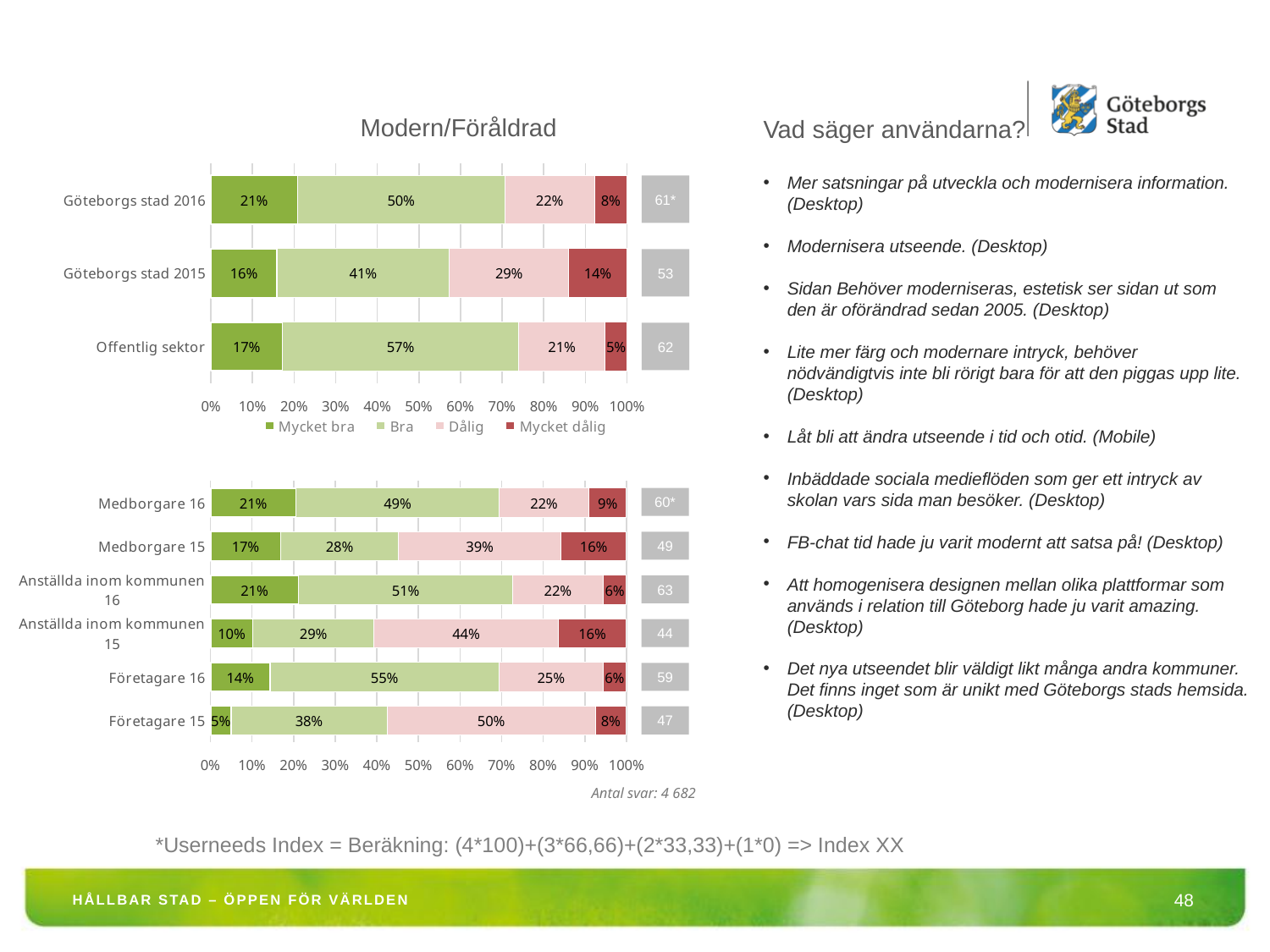
In the top chart titled Modern/Föråldrad, what is the Mycket dålig value for Göteborgs stad 2015? 14% In the top chart titled Modern/Föråldrad, which category has the lowest Mycket dålig value? Offentlig sektor In the top chart titled Modern/Föråldrad, what is the Bra value for Offentlig sektor? 57% In the bottom chart, which category has the highest Bra value? Företagare 16 In the bottom chart, which category has the lowest Mycket bra value? Företagare 15 In the bottom chart, what is the Dålig value for Företagare 15? 50% In the top chart titled Modern/Föråldrad, how many categories are shown? 3 In the top chart titled Modern/Föråldrad, which category has the highest Mycket bra value? Göteborgs stad 2016 What kind of chart is the bottom chart? Stacked bar chart In the bottom chart, is the Dålig value larger for Medborgare 15 or for Medborgare 16? Medborgare 15 In the top chart titled Modern/Föråldrad, what is the difference between the Bra values for Göteborgs stad 2016 and Göteborgs stad 2015? 9% In the top chart titled Modern/Föråldrad, how many series does the legend list? 4